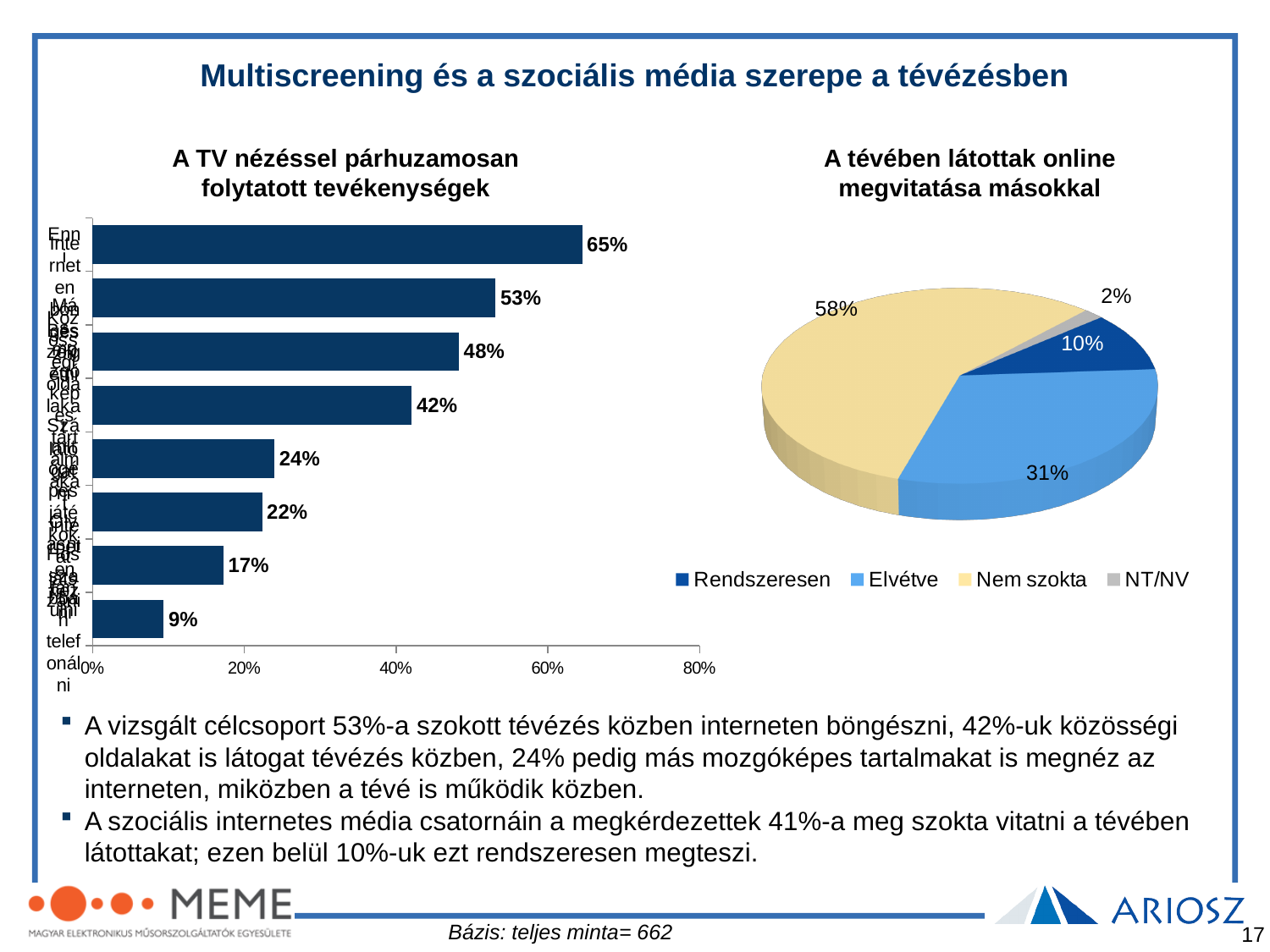
In the chart 'A TV nézéssel párhuzamosan folytatott tevékenységek', what is the value of the longest bar? 65% How many bars are plotted in the chart 'A TV nézéssel párhuzamosan folytatott tevékenységek'? 8 In the pie chart 'A tévében látottak online megvitatása másokkal', which is larger: the share for 'Rendszeresen' or for 'Elvétve'? Elvétve In the chart 'A TV nézéssel párhuzamosan folytatott tevékenységek', what is the value of the shortest bar? 9% What kind of chart is 'A TV nézéssel párhuzamosan folytatott tevékenységek' on the left of the slide? Bar chart In the pie chart 'A tévében látottak online megvitatása másokkal', what share is labelled for 'Nem szokta'? 58% In the pie chart 'A tévében látottak online megvitatása másokkal', how many entries does the legend list? 4 In the pie chart 'A tévében látottak online megvitatása másokkal', what share is labelled for 'Elvétve'? 31% In the pie chart 'A tévében látottak online megvitatása másokkal', which category has the smallest slice? NT/NV In the pie chart 'A tévében látottak online megvitatása másokkal', what share is labelled for 'Rendszeresen'? 10% In the pie chart 'A tévében látottak online megvitatása másokkal', what is the difference between the shares for 'Nem szokta' and 'Elvétve'? 27% In the pie chart 'A tévében látottak online megvitatása másokkal', which category has the largest slice? Nem szokta